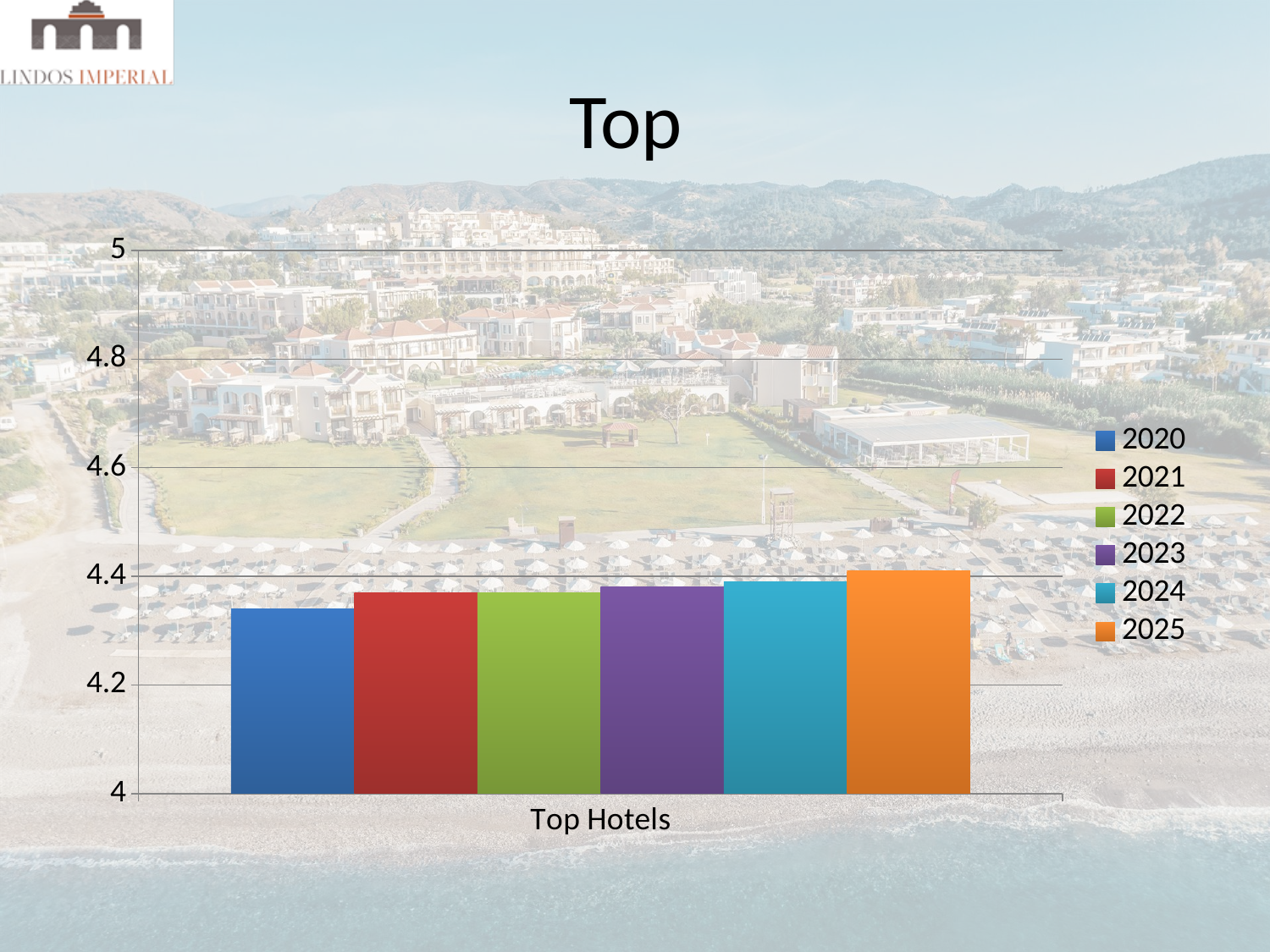
Is the value for 2021 greater or less than 4.2? greater Which year has the lowest bar for Top Hotels? 2020 What is the title of the slide? Top What is the category label shown on the x axis? Top Hotels Is the value for 2020 greater or less than 4.4? less Do the bars rise or fall from 2020 to 2025? rise Which is larger, the value for 2020 or the value for 2025? 2025 How many series does the legend list? 6 How many categories are shown on the x axis? 1 Which year has the highest bar for Top Hotels? 2025 What kind of chart is shown on the slide? bar chart